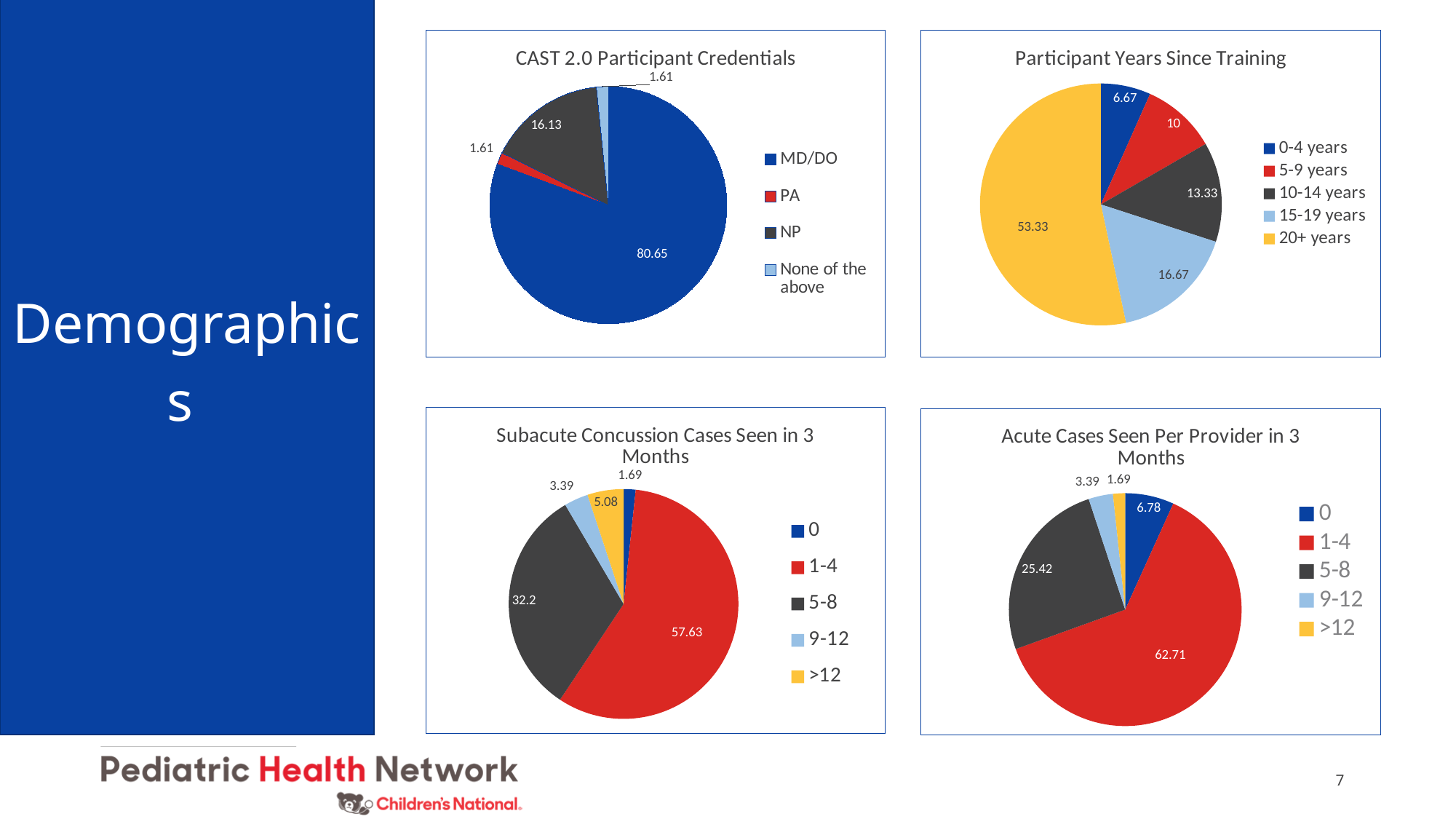
What type of chart is the 'Participant Years Since Training' chart? Pie chart How many categories does the legend of the 'Acute Cases Seen Per Provider in 3 Months' chart list? 5 In the 'Participant Years Since Training' chart, which category has the smallest slice? 0-4 years In the 'Subacute Concussion Cases Seen in 3 Months' chart, what is the value for 5-8? 32.2 In the 'Participant Years Since Training' chart, which category has the largest slice? 20+ years In the 'Subacute Concussion Cases Seen in 3 Months' chart, which is larger, the value for >12 or the value for 9-12? >12 In the 'CAST 2.0 Participant Credentials' chart, what is the value for NP? 16.13 In the 'Participant Years Since Training' chart, what is the value for 15-19 years? 16.67 In the 'CAST 2.0 Participant Credentials' chart, what is the value for MD/DO? 80.65 In the 'Acute Cases Seen Per Provider in 3 Months' chart, what is the value for 1-4? 62.71 In the 'Acute Cases Seen Per Provider in 3 Months' chart, what is the difference between the 1-4 and 5-8 values? 37.29 In the 'Participant Years Since Training' chart, what is the difference between the 10-14 years and 5-9 years values? 3.33